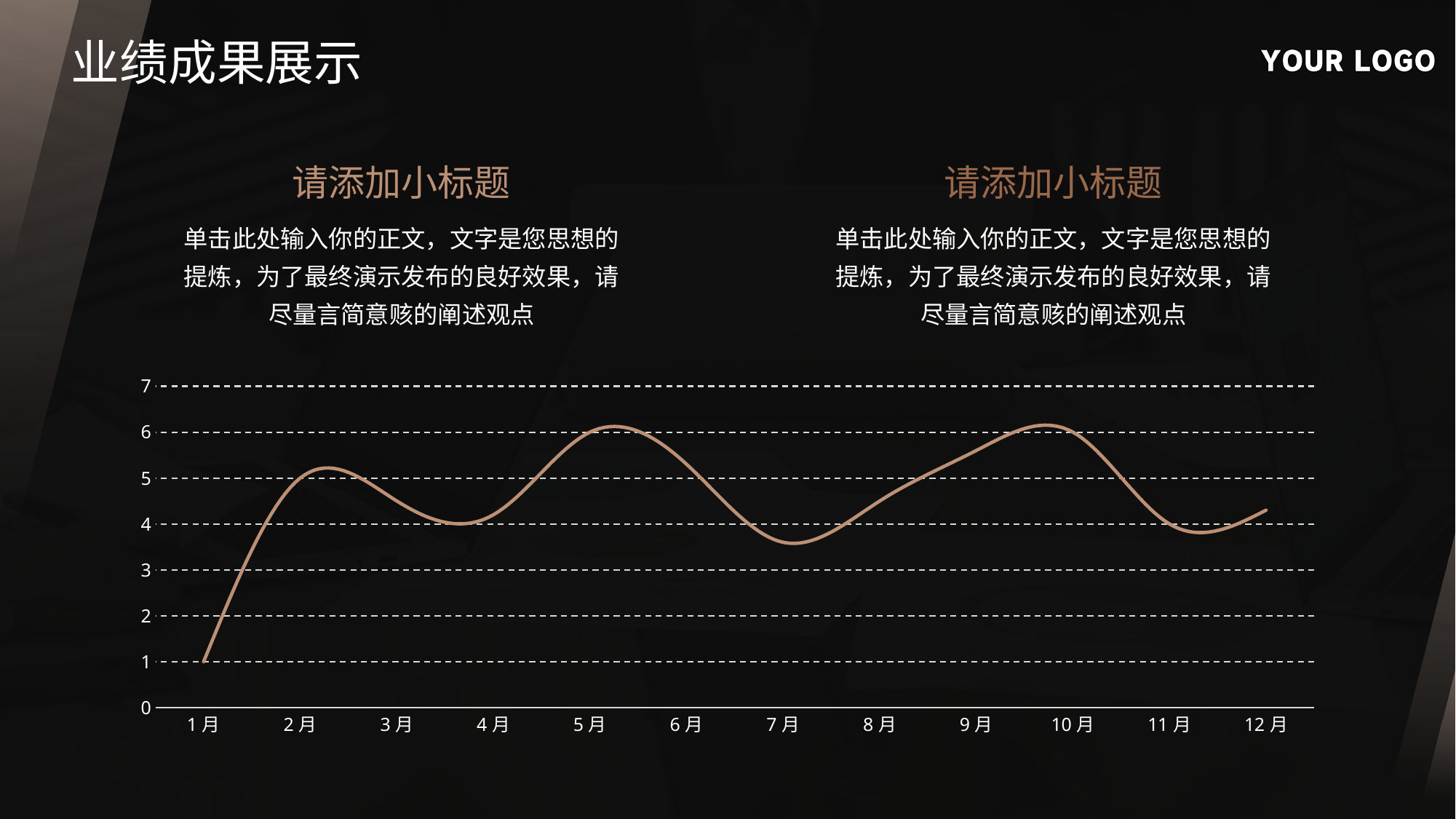
Is the value for 10月 greater or less than 5? greater Is the value for 11月 greater or less than 5? less Is the value for 7月 greater or less than 4? less How many months are plotted along the x axis of the chart? 12 What is the value for 1月 on the chart? 1 What is the highest value shown on the y axis of the chart? 7 Does the line rise or fall from 1月 to 2月? rises What kind of chart is shown on the slide? line chart Which month has the lowest value on the chart? 1月 Which is larger, the value for 5月 or the value for 7月? 5月